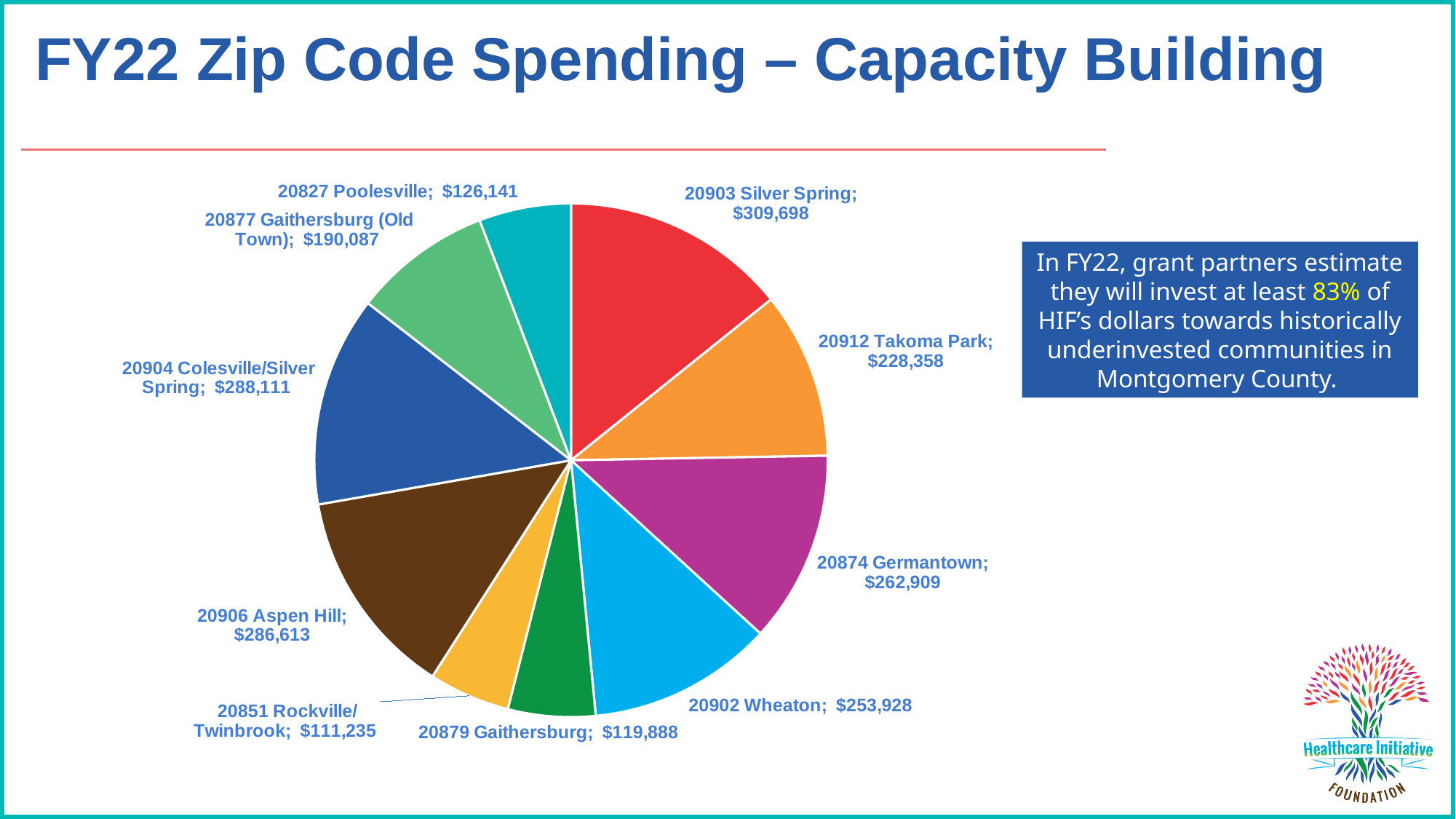
Which zip code has the highest spending in the pie chart? 20903 Silver Spring What type of chart is shown on the slide? pie chart What is the spending value for 20877 Gaithersburg (Old Town)? $190,087 What is the difference in spending between 20827 Poolesville and 20879 Gaithersburg? $6,253 How many zip code slices are shown in the pie chart? 10 Which has higher spending, 20874 Germantown or 20912 Takoma Park? 20874 Germantown What is the spending value for 20874 Germantown? $262,909 Which zip code has the lowest spending in the pie chart? 20851 Rockville/Twinbrook What is the title of the slide containing the pie chart? FY22 Zip Code Spending – Capacity Building What is the FY22 capacity building spending for 20903 Silver Spring? $309,698 What is the spending value for 20851 Rockville/Twinbrook? $111,235 What is the difference in spending between 20903 Silver Spring and 20912 Takoma Park? $81,340